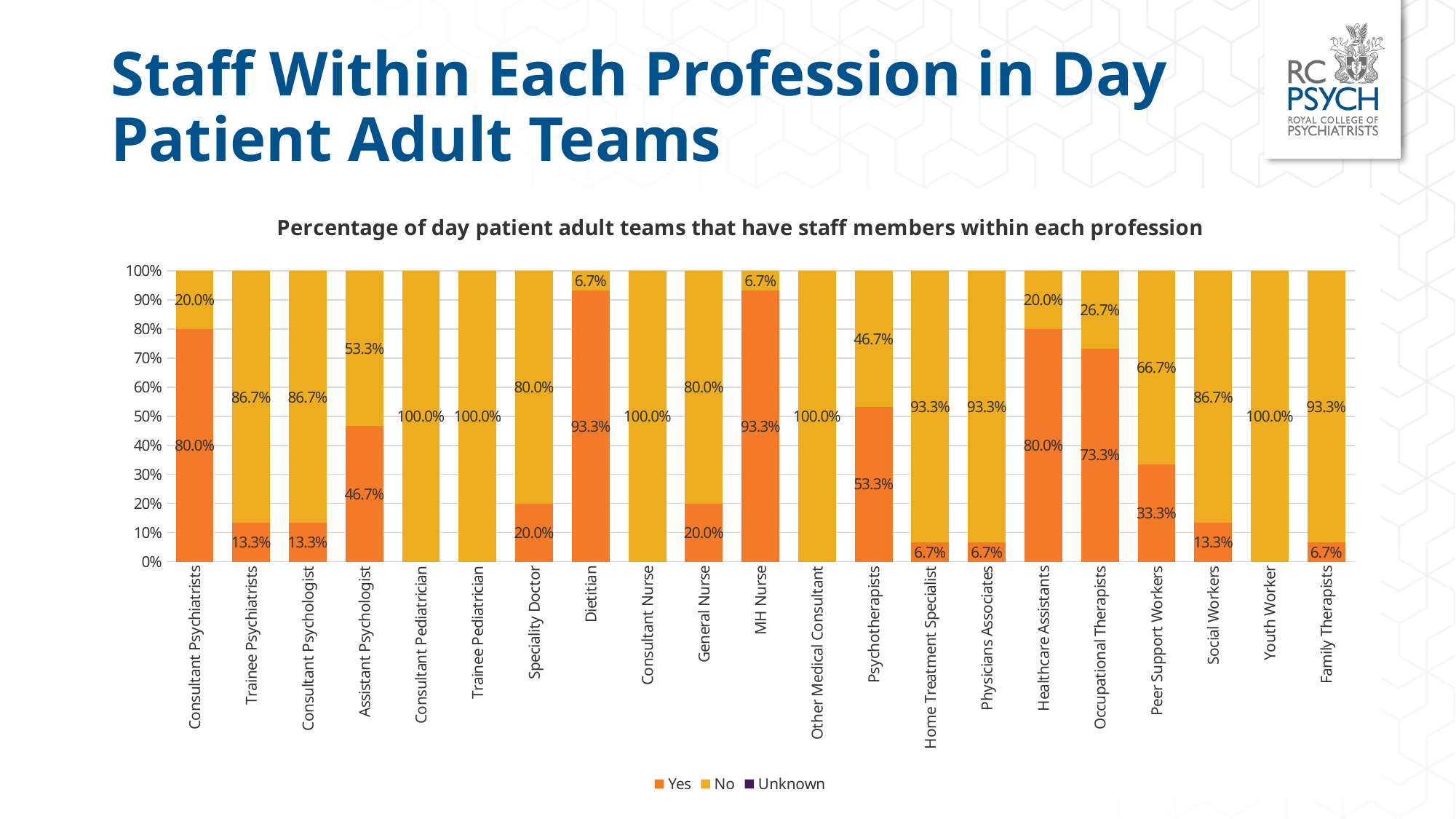
Which has a larger 'No' percentage, Trainee Psychiatrists or Speciality Doctor? Trainee Psychiatrists What is the 'No' percentage for Assistant Psychologist? 53.3% What is the 'Yes' percentage for Occupational Therapists? 73.3% What kind of chart is shown on the slide? Stacked bar chart What is the difference between the 'Yes' percentage for Dietitian and the 'Yes' percentage for Peer Support Workers? 60.0% How many professions are shown on the x axis of the chart? 21 What is the 'Yes' percentage for Consultant Psychiatrists? 80.0% What is the 'No' percentage for Peer Support Workers? 66.7% What is the 'No' percentage for Youth Worker? 100.0% Which has a larger 'Yes' percentage, Healthcare Assistants or Psychotherapists? Healthcare Assistants What is the title of the chart? Percentage of day patient adult teams that have staff members within each profession How many series does the legend list? 3